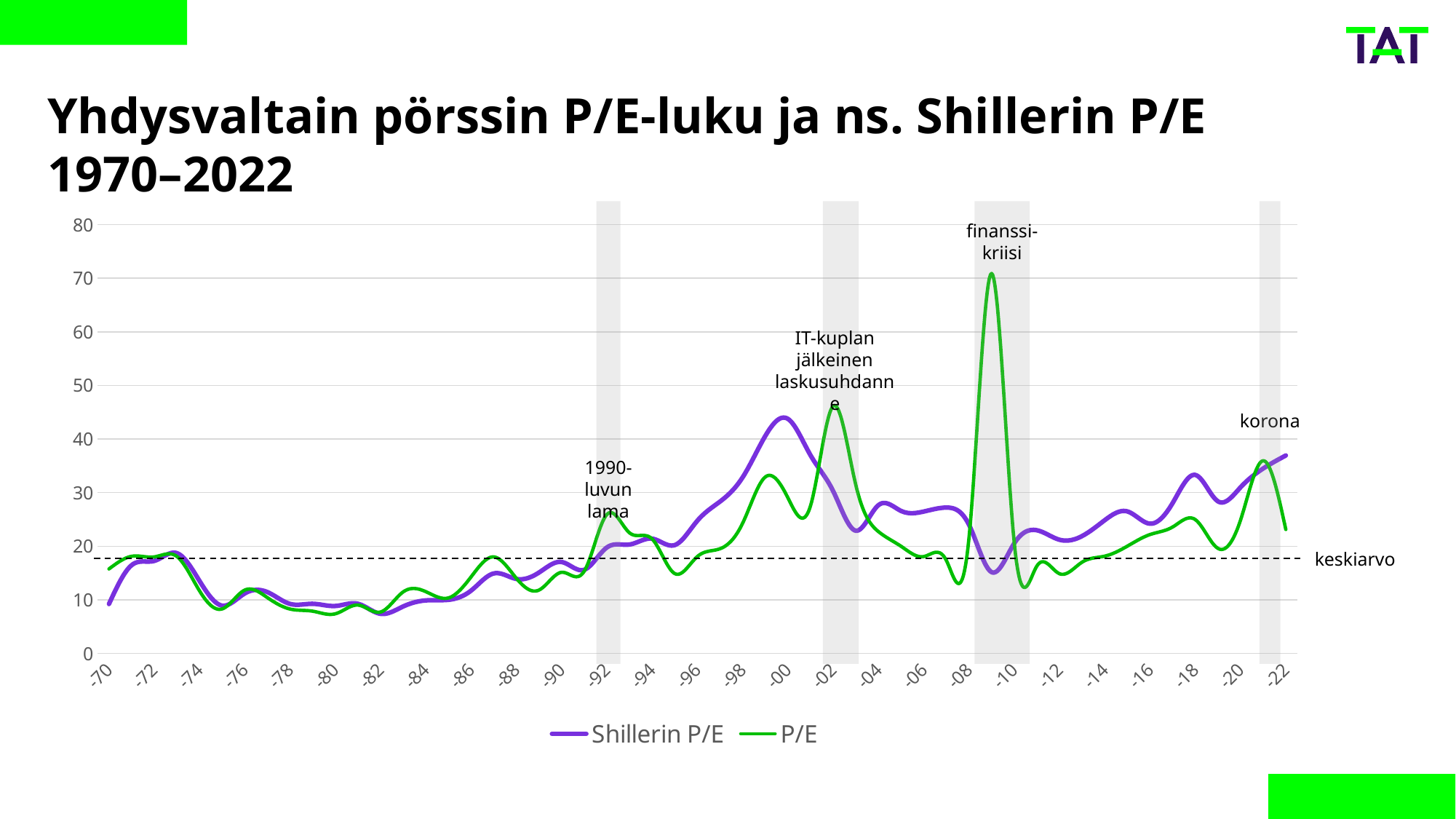
Is the value of the Shillerin P/E series around 1982 greater or less than 10? less Is the value of the Shillerin P/E series at 2022 greater or less than 30? greater Which two series are listed in the legend? Shillerin P/E and P/E Does the Shillerin P/E series overall rise or fall from 1970 to 2022? rise Around the year 2000, which series has the higher value, Shillerin P/E or P/E? Shillerin P/E What kind of chart is shown on the slide? line chart Is the dashed keskiarvo line greater or less than 20? less How many series does the legend list? 2 Which series reaches the highest value anywhere on the chart? P/E What is the title of the chart on the slide? Yhdysvaltain pörssin P/E-luku ja ns. Shillerin P/E 1970–2022